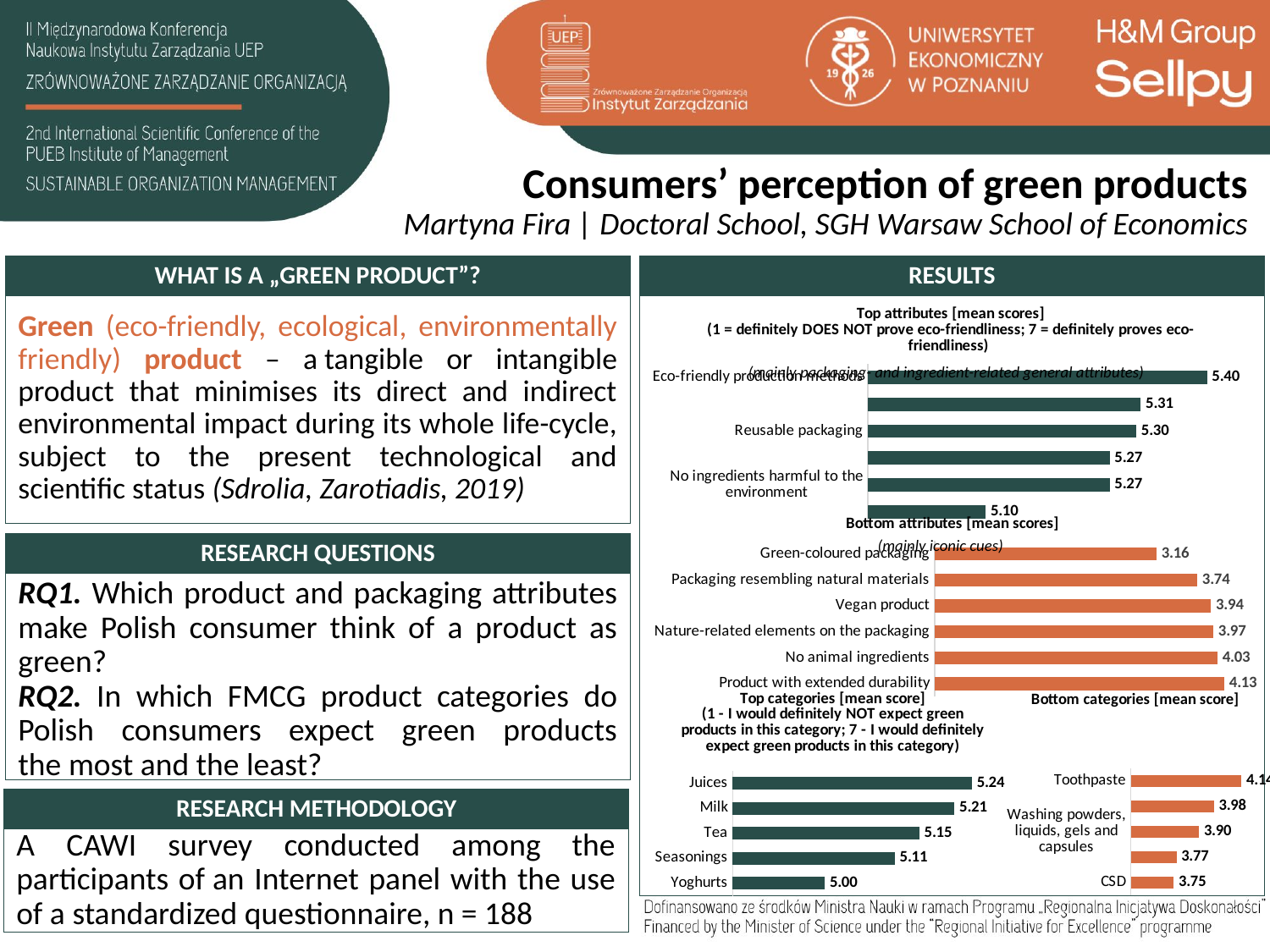
In the 'Top categories' chart, which product category has the highest mean score? Juices In the 'Bottom attributes' chart, what is the mean score for Vegan product? 3.94 In the 'Top categories' chart, which has a higher mean score, Milk or Tea? Milk In the 'Top attributes' chart, what is the mean score for Reusable packaging? 5.30 In the 'Bottom categories' chart, what is the mean score for Washing powders, liquids, gels and capsules? 3.90 In the 'Bottom attributes' chart, which attribute has the lowest mean score? Green-coloured packaging In the 'Top attributes' chart, what is the mean score for Eco-friendly production methods? 5.40 In the 'Top categories' chart, what is the mean score for Yoghurts? 5.00 In the 'Bottom attributes' chart, what is the difference between the mean scores for Product with extended durability and Green-coloured packaging? 0.97 In the 'Bottom attributes' chart, how many attributes are plotted? 6 In the 'Bottom categories' chart, what is the mean score for CSD? 3.75 What type of chart is the 'Top categories' chart? Bar chart